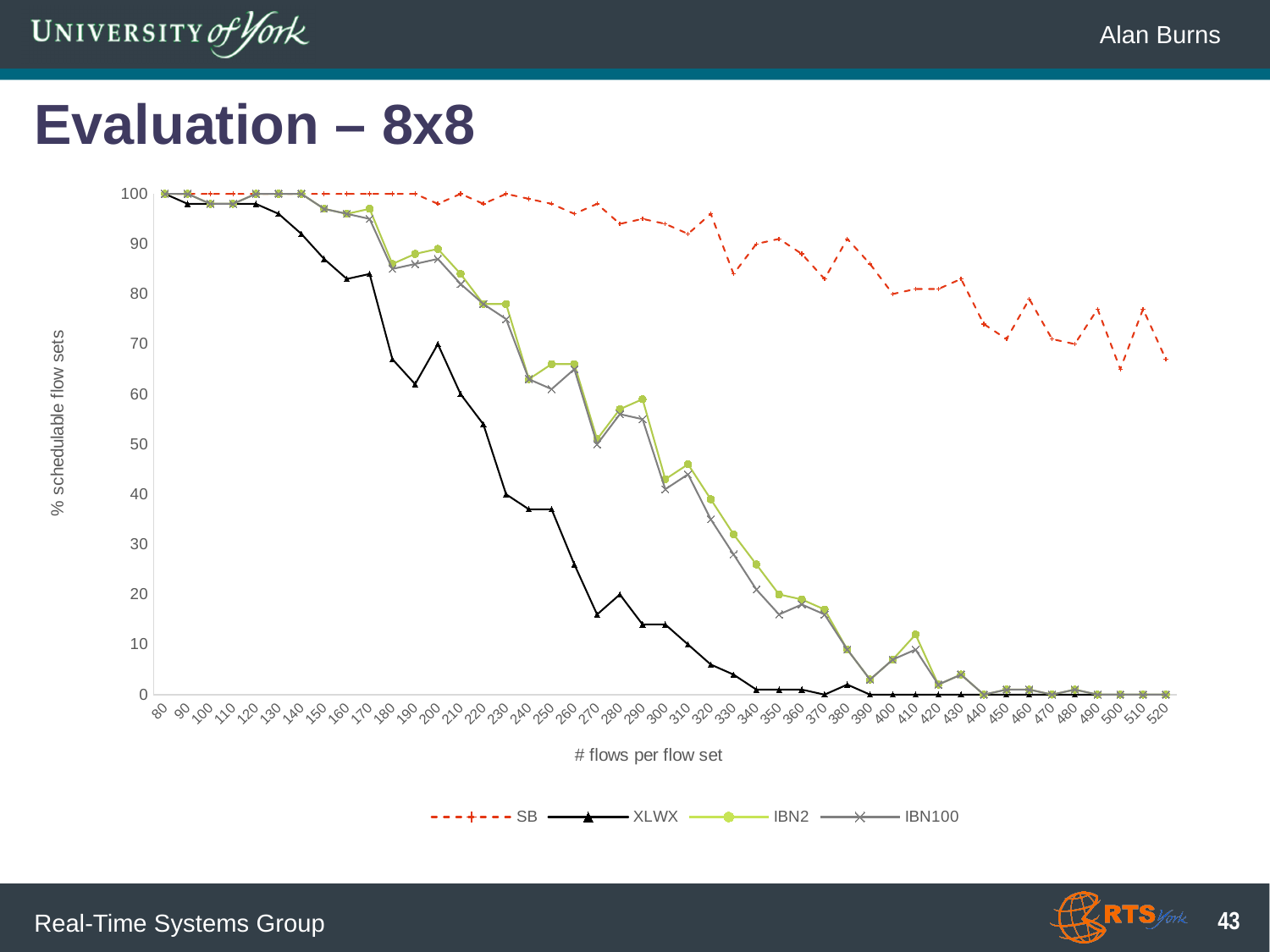
At 250 flows per flow set, which is larger: IBN2 or XLWX? IBN2 What kind of chart is shown on the slide? line chart Is the value for IBN100 at 350 flows per flow set greater or less than 20? less Which series has the lowest value at 300 flows per flow set? XLWX What is the value of the SB series at 80 flows per flow set? 100 Which series are listed in the legend? SB, XLWX, IBN2, IBN100 Is the value for SB at 520 flows per flow set greater or less than 60? greater Which series has the highest value at 400 flows per flow set? SB Does the XLWX series rise or fall as the number of flows per flow set increases? fall What is the label of the y axis? % schedulable flow sets How many series does the legend list? 4 How many x-axis categories (flows per flow set values) are plotted? 45